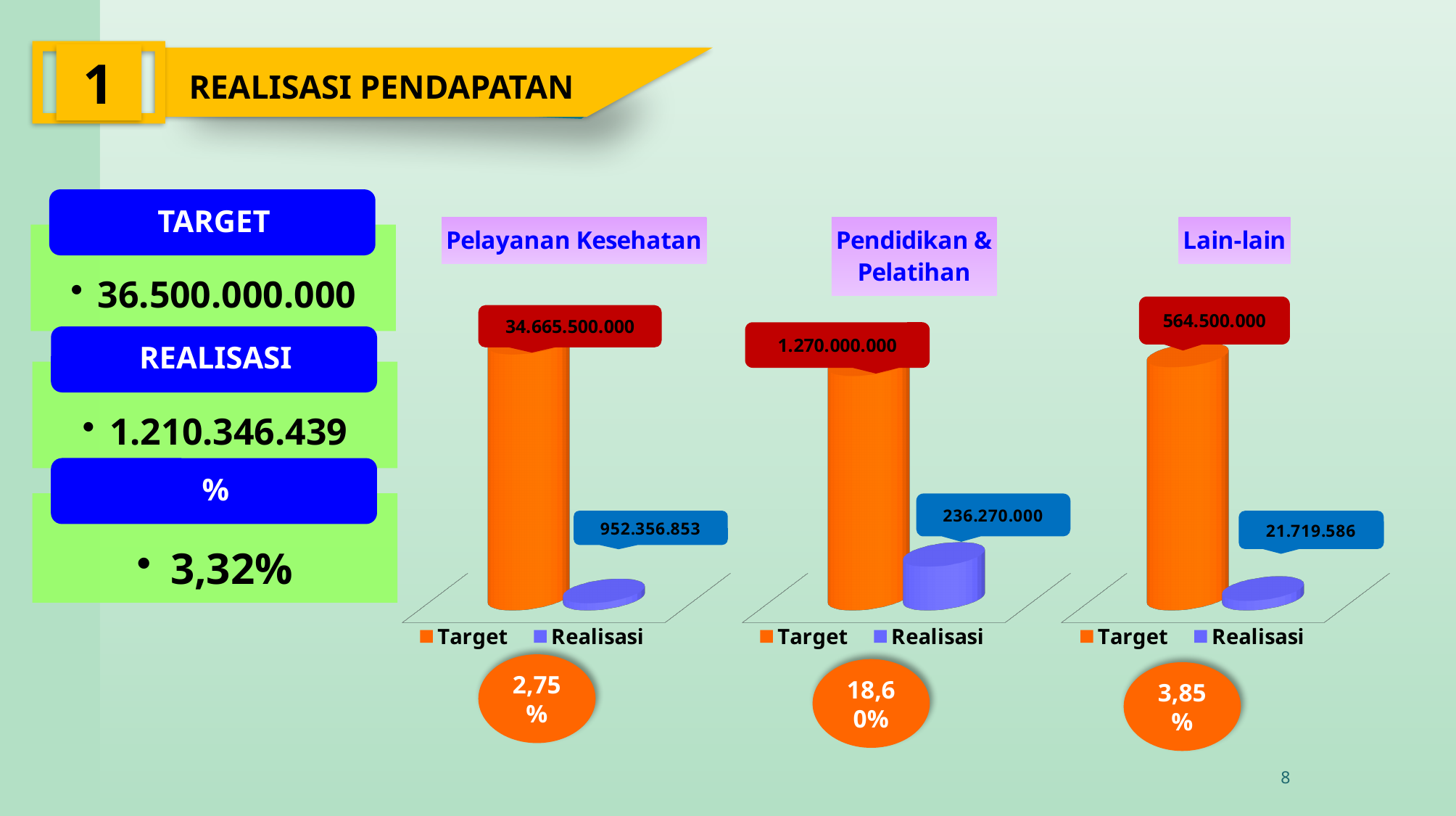
What kind of chart is the Pendidikan & Pelatihan chart? Bar chart How many series does the legend of the Lain-lain chart list? 2 In the Pelayanan Kesehatan chart, which is larger, Target or Realisasi? Target In the Pelayanan Kesehatan chart, what is the value of Target? 34.665.500.000 In the Pendidikan & Pelatihan chart, what is the value of Realisasi? 236.270.000 In the Pelayanan Kesehatan chart, what colour is the Target bar? Orange In the Lain-lain chart, what is the value of Realisasi? 21.719.586 In the Pelayanan Kesehatan chart, what is the value of Realisasi? 952.356.853 In the Pendidikan & Pelatihan chart, what is the difference between Target and Realisasi? 1.033.730.000 In the Lain-lain chart, what is the difference between Target and Realisasi? 542.780.414 In the Pendidikan & Pelatihan chart, what is the value of Target? 1.270.000.000 In the Lain-lain chart, what is the value of Target? 564.500.000